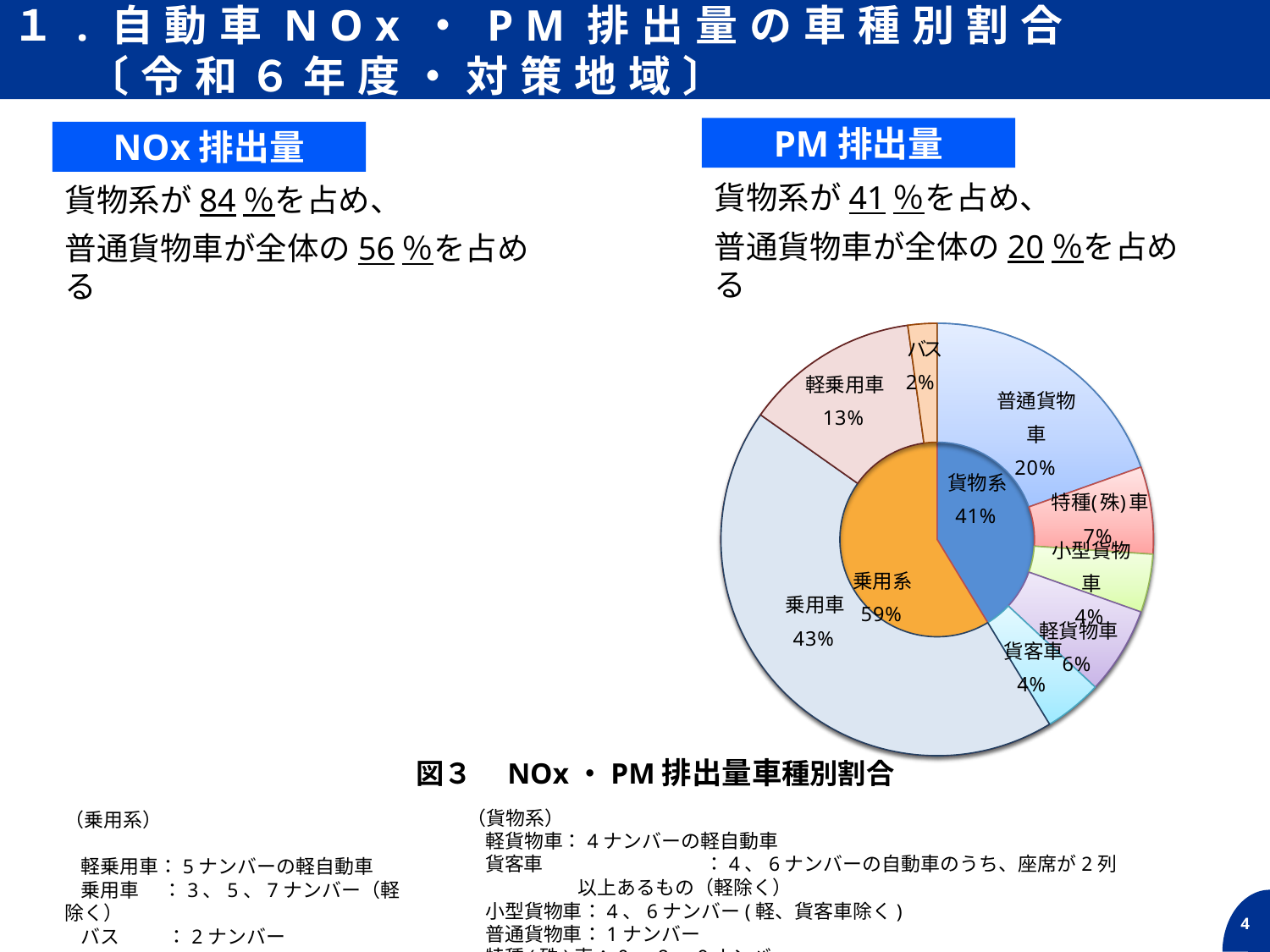
In the PM emissions pie chart, which outer-ring category has the largest share? 乗用車 In the PM emissions pie chart, what share is labelled for 普通貨物車? 20% In the PM emissions pie chart, what share is labelled for バス? 2% In the PM emissions pie chart, what share does the inner ring show for 乗用系? 59% In the PM emissions pie chart, what is the difference between the shares of 乗用車 and 普通貨物車? 23% In the PM emissions pie chart, which outer-ring category has the smallest share? バス In the PM emissions pie chart, what share does the inner ring show for 貨物系? 41% What kind of chart is shown on the slide? pie chart In the PM emissions pie chart, what share is labelled for 軽乗用車? 13% In the PM emissions pie chart, what share is labelled for 乗用車? 43% In the PM emissions pie chart, which has the larger share, 軽貨物車 or 特種(殊)車? 特種(殊)車 How many categories are labelled in the outer ring of the PM emissions pie chart? 8